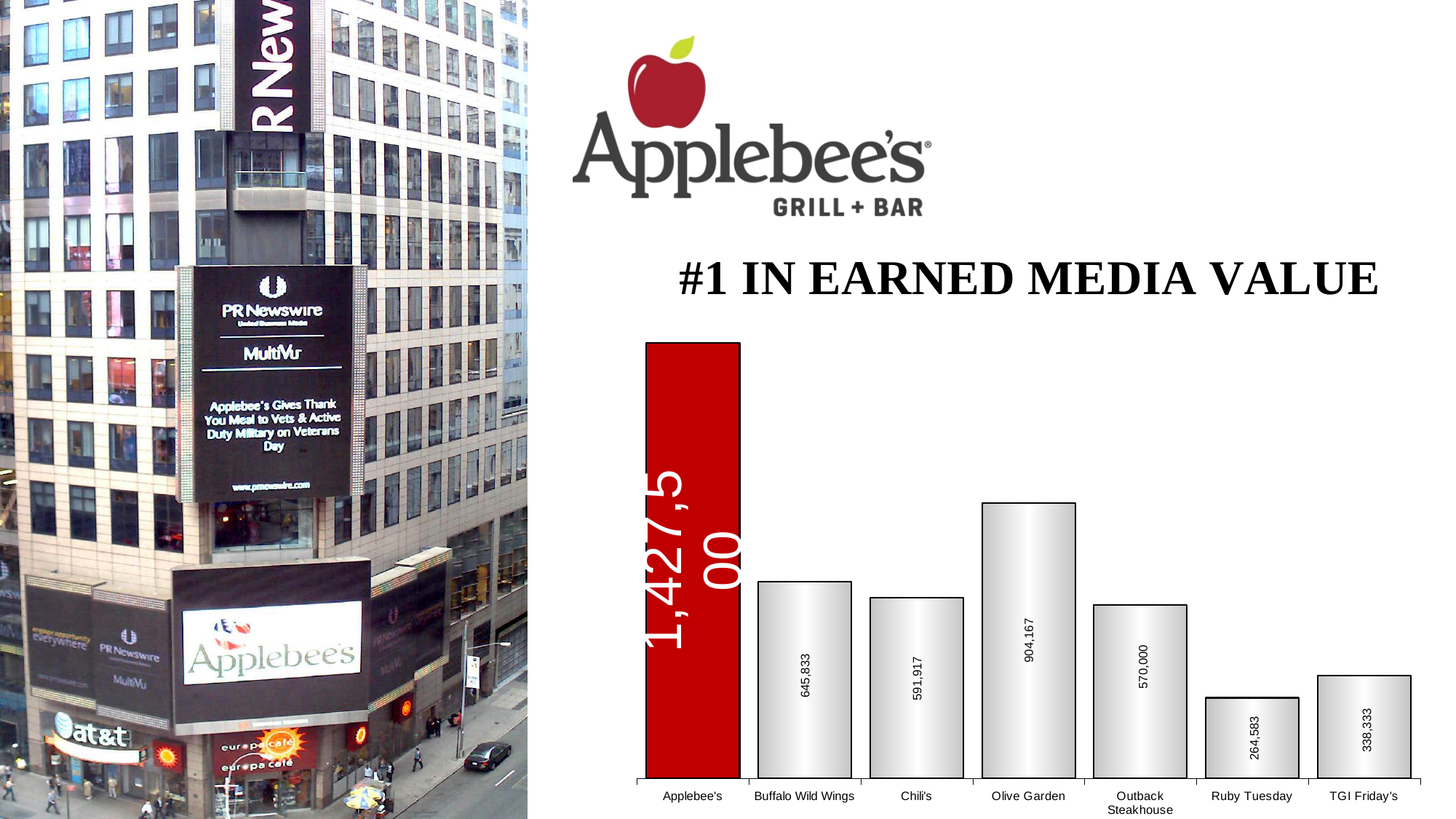
Which has a larger value, Buffalo Wild Wings or TGI Friday's? Buffalo Wild Wings What is the value shown for Olive Garden? 904,167 What is the difference between the values for Olive Garden and Buffalo Wild Wings? 258,334 What is the earned media value shown for Applebee's? 1,427,500 What is the value shown for Ruby Tuesday? 264,583 What is the difference between the values for TGI Friday's and Ruby Tuesday? 73,750 What colour is the Applebee's bar in the chart? Red Which restaurant has the lowest earned media value in the chart? Ruby Tuesday Which restaurant has the highest earned media value in the chart? Applebee's What type of chart is shown on the slide? Bar chart What is the value shown for Outback Steakhouse? 570,000 How many restaurants are shown in the chart? 7